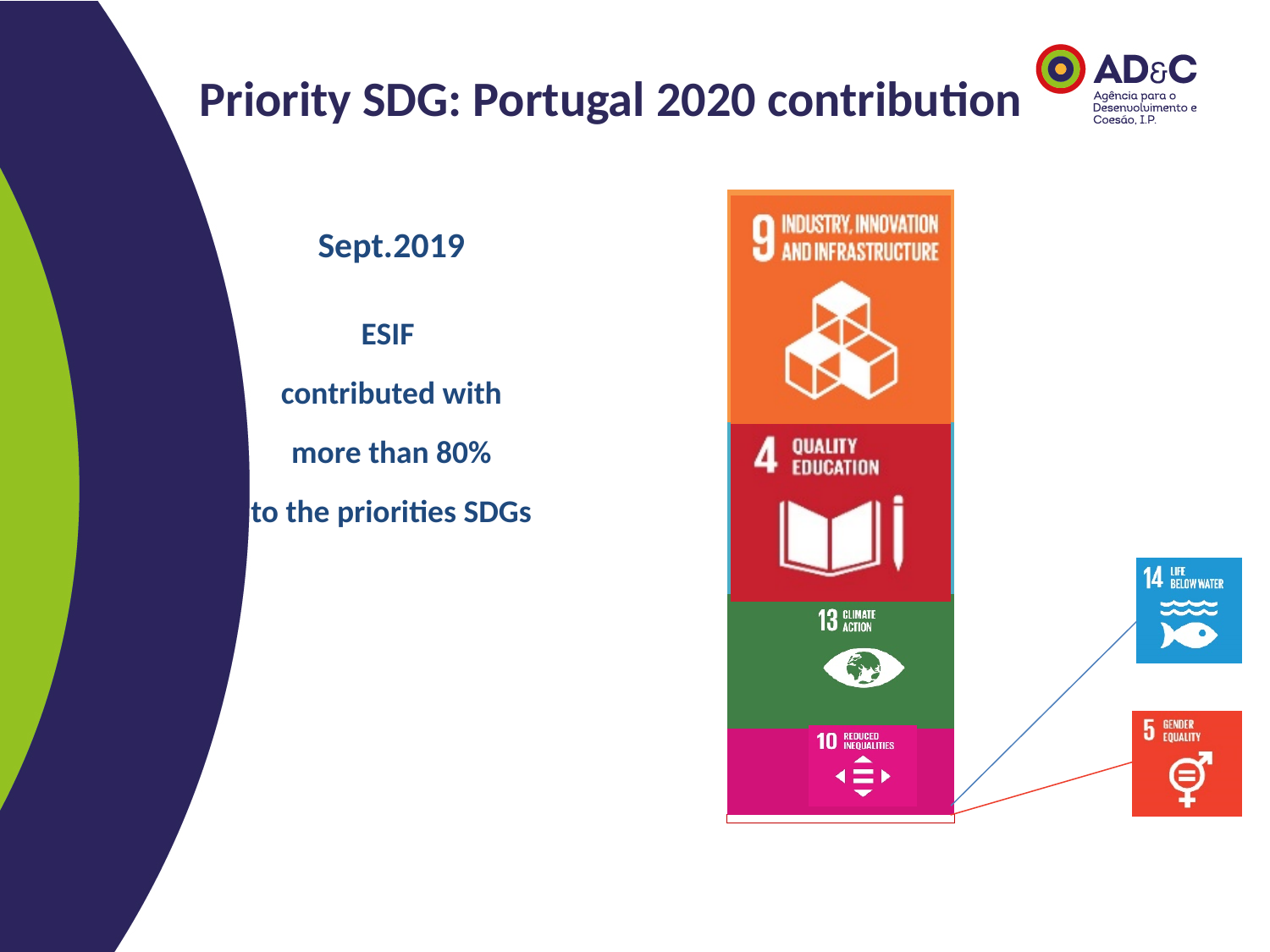
Which segment is larger in the stacked bar: SDG 4 Quality Education or SDG 14 Life Below Water? SDG 4 Quality Education What kind of chart is shown on the slide? stacked bar chart Which two SDGs are shown as the very small segments at the bottom of the stacked bar, called out with lines? 14 Life Below Water and 5 Gender Equality Which segment is larger in the stacked bar: SDG 4 Quality Education or SDG 13 Climate Action? SDG 4 Quality Education Which segment is larger in the stacked bar: SDG 13 Climate Action or SDG 10 Reduced Inequalities? SDG 13 Climate Action How many SDG segments make up the stacked bar, including the two small ones called out at the bottom? 6 What is the title of the slide containing the chart? Priority SDG: Portugal 2020 contribution Which SDG occupies the largest segment of the stacked bar? 9 Industry, Innovation and Infrastructure Which SDG segment sits at the top of the stacked bar? 9 Industry, Innovation and Infrastructure